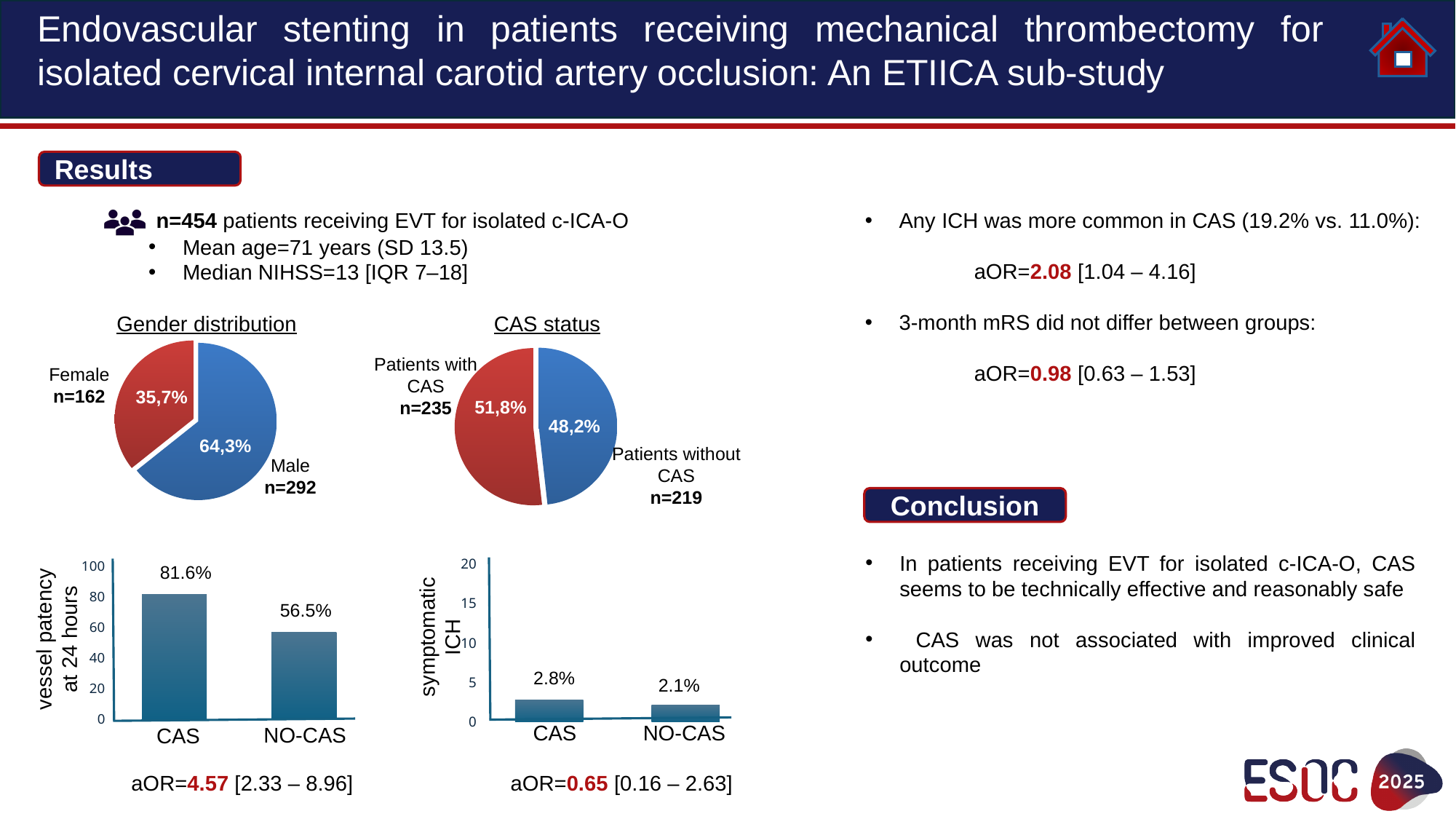
In the symptomatic ICH bar chart, which category has the higher value? CAS In the vessel patency at 24 hours bar chart, what is the difference between the CAS and NO-CAS values? 25.1% In the CAS status pie chart, how many patients are in the 'Patients with CAS' group? n=235 In the Gender distribution pie chart, what percentage of patients are female? 35,7% In the Gender distribution pie chart, what percentage of patients are male? 64,3% In the vessel patency at 24 hours bar chart, is the value for NO-CAS greater or less than 60? less How many categories are shown in the symptomatic ICH bar chart? 2 In the symptomatic ICH bar chart, what is the value for NO-CAS? 2.1% In the CAS status pie chart, what percentage of patients are without CAS? 48,2% In the vessel patency at 24 hours bar chart, what is the value for CAS? 81.6% What kind of chart is used to show the Gender distribution? Pie chart In the CAS status pie chart, which group has the larger share: patients with CAS or patients without CAS? Patients with CAS